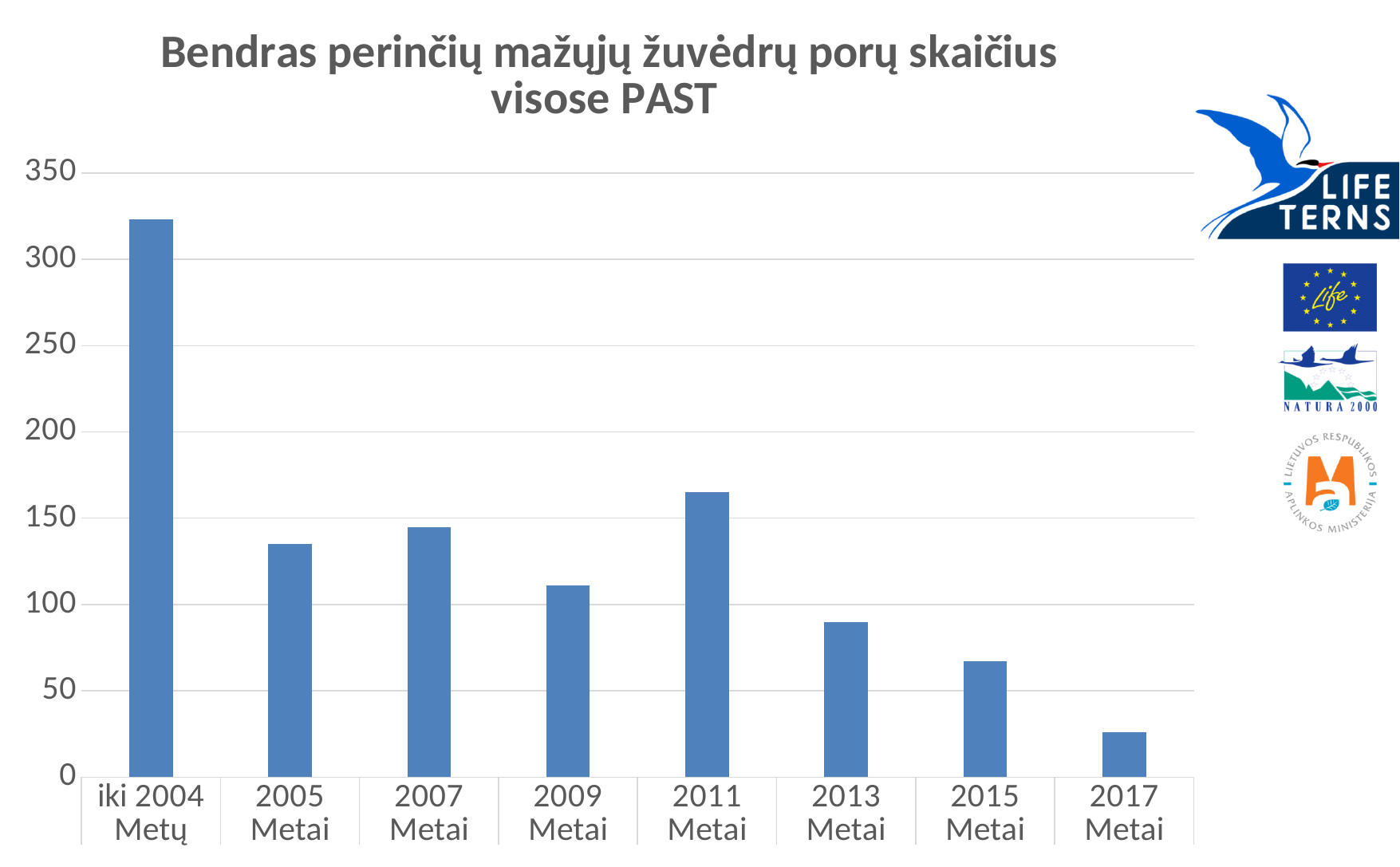
Is the value for 2011 Metai greater or less than 150? greater What is the title of the chart? Bendras perinčių mažųjų žuvėdrų porų skaičius visose PAST Is the value for 2017 Metai greater or less than 50? less Which is larger, the value for 2011 Metai or the value for 2007 Metai? 2011 Metai Which is larger, the value for 2013 Metai or the value for 2015 Metai? 2013 Metai Which category has the lowest value in the chart? 2017 Metai Do the values rise or fall from 2011 Metai to 2017 Metai? fall What kind of chart is shown on the slide? bar chart Is the value for 2009 Metai greater or less than 100? greater How many categories are shown on the x axis of the chart? 8 Which category has the highest value in the chart? iki 2004 Metų